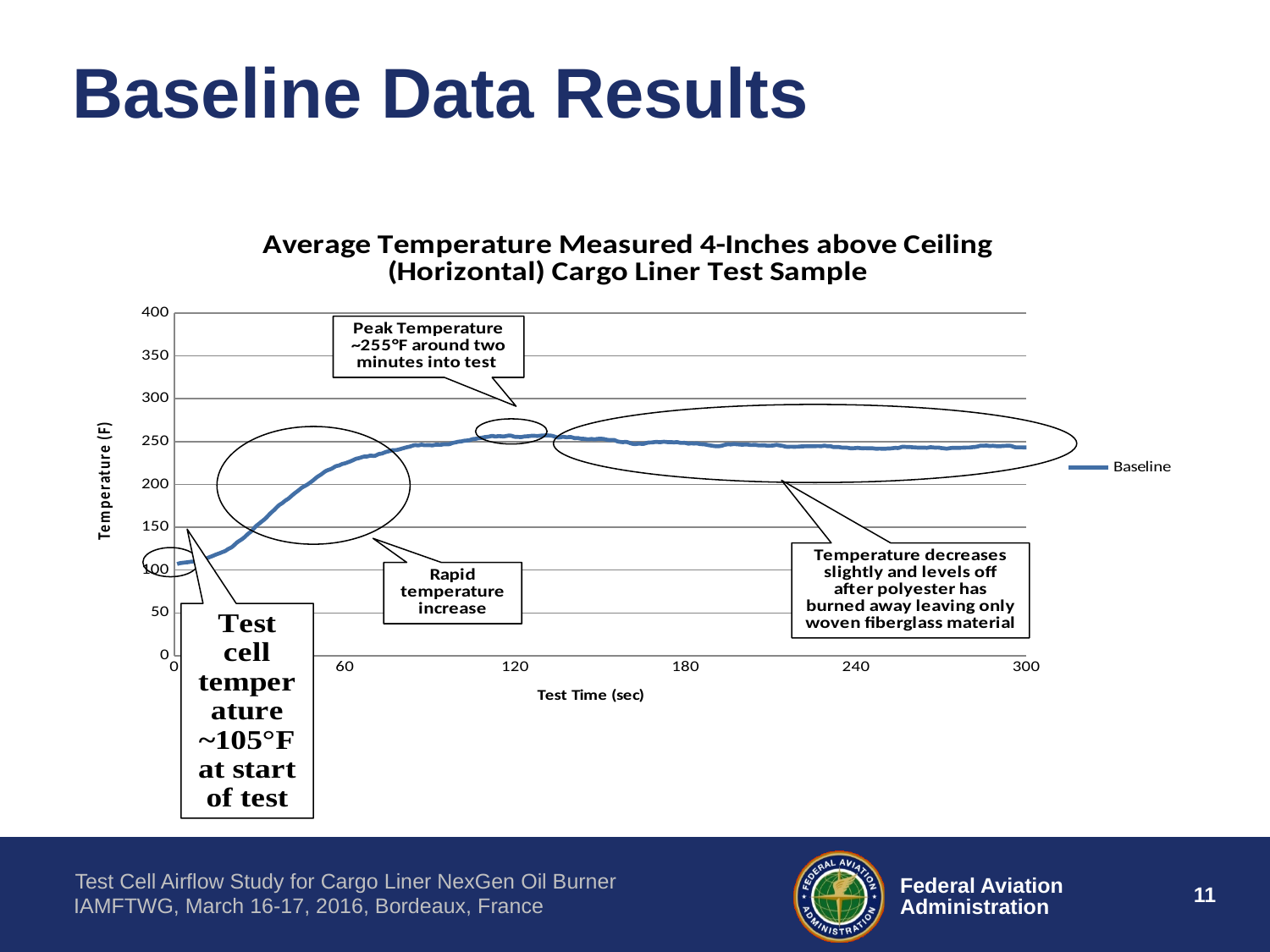
Is the Baseline temperature at 300 seconds greater or less than 300? less Is the Baseline temperature at 120 seconds greater or less than 200? greater Is the Baseline temperature at 240 seconds greater or less than 200? greater Which is larger, the Baseline temperature at 30 seconds or at 240 seconds? 240 seconds What is the title of the chart? Average Temperature Measured 4-Inches above Ceiling (Horizontal) Cargo Liner Test Sample What kind of chart is shown on the slide? line chart Does the Baseline temperature rise or fall between 120 and 300 seconds? fall What is the name of the series shown in the chart's legend? Baseline How many series does the chart's legend list? 1 Does the Baseline temperature rise or fall between 0 and 120 seconds? rise